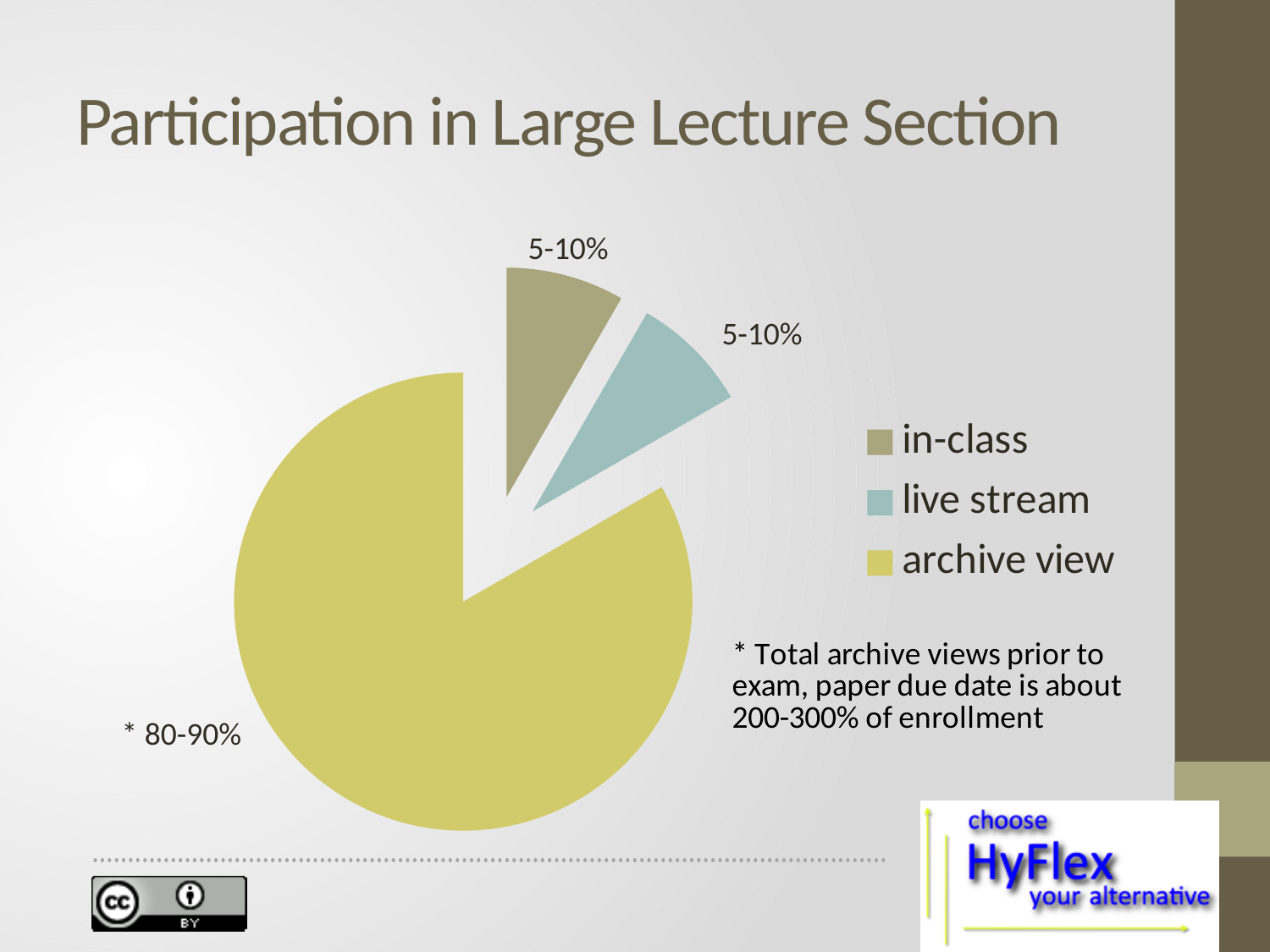
What kind of chart is shown on the slide? pie chart Which slice is larger, archive view or live stream? archive view What label is shown for the live stream slice? 5-10% What label is shown for the in-class slice? 5-10% Which legend entry is shown in light blue? live stream What is the title of the chart? Participation in Large Lecture Section How many entries does the legend list? 3 Which category has the largest slice of the pie? archive view How many slices does the pie chart have? 3 Which slice is larger, in-class or archive view? archive view What label is shown for the archive view slice? * 80-90% Is the share for archive view greater or less than 50%? greater